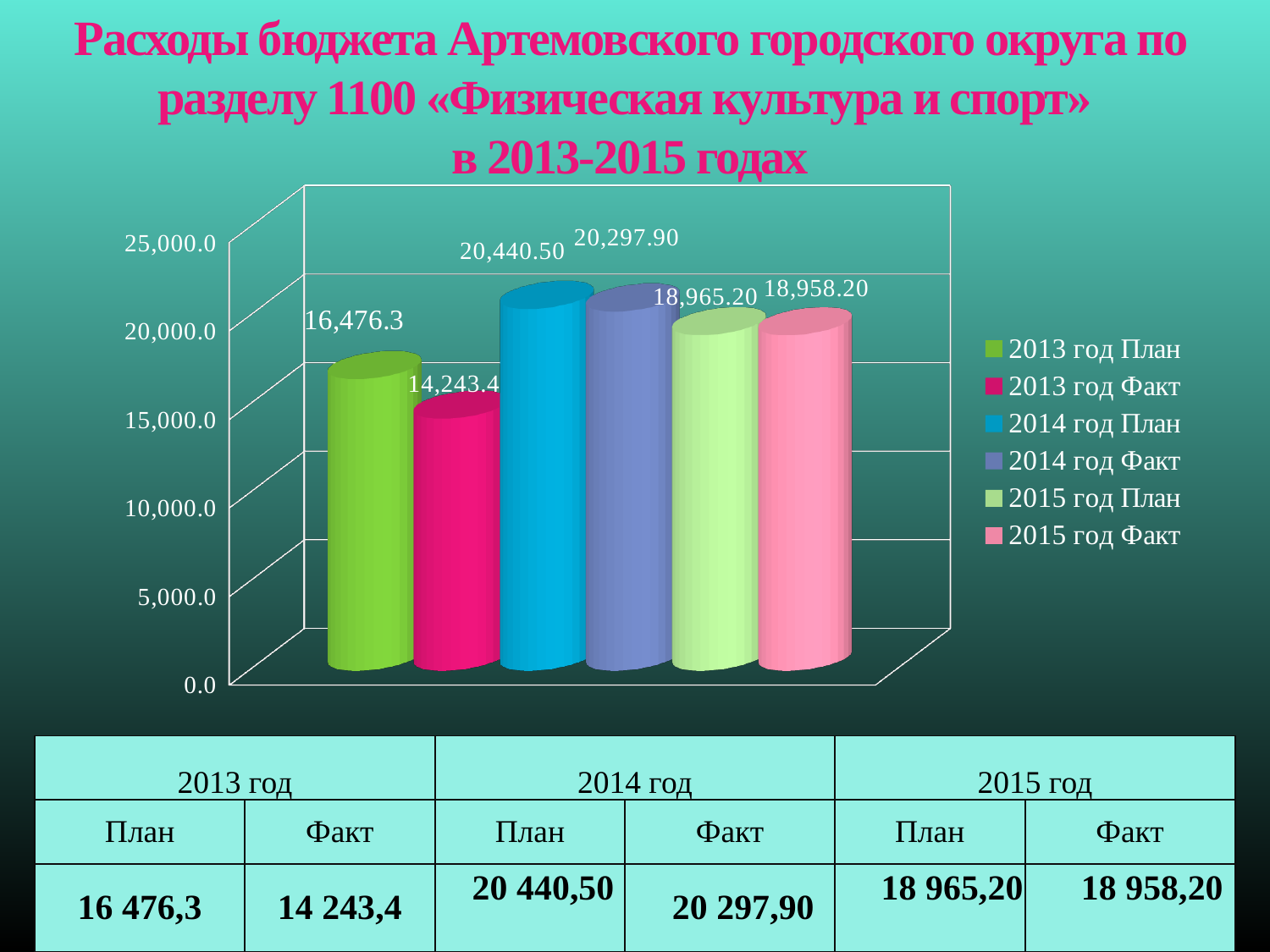
Which series has the lowest value in the chart? 2013 год Факт What is the difference between the 2013 год План and 2013 год Факт values? 2,232.9 Which is larger, the 2014 год Факт value or the 2015 год План value? 2014 год Факт What is the difference between the 2014 год План and 2014 год Факт values? 142.60 How many series does the legend list? 6 Is the value for 2013 год Факт greater or less than 15,000.0? less What kind of chart is shown on the slide? bar chart What is the value shown for the 2013 год Факт bar? 14,243.4 Which series has the highest value in the chart? 2014 год План What is the value shown for the 2013 год План bar? 16,476.3 What is the value shown for the 2015 год Факт bar? 18,958.20 What is the value shown for the 2014 год План bar? 20,440.50